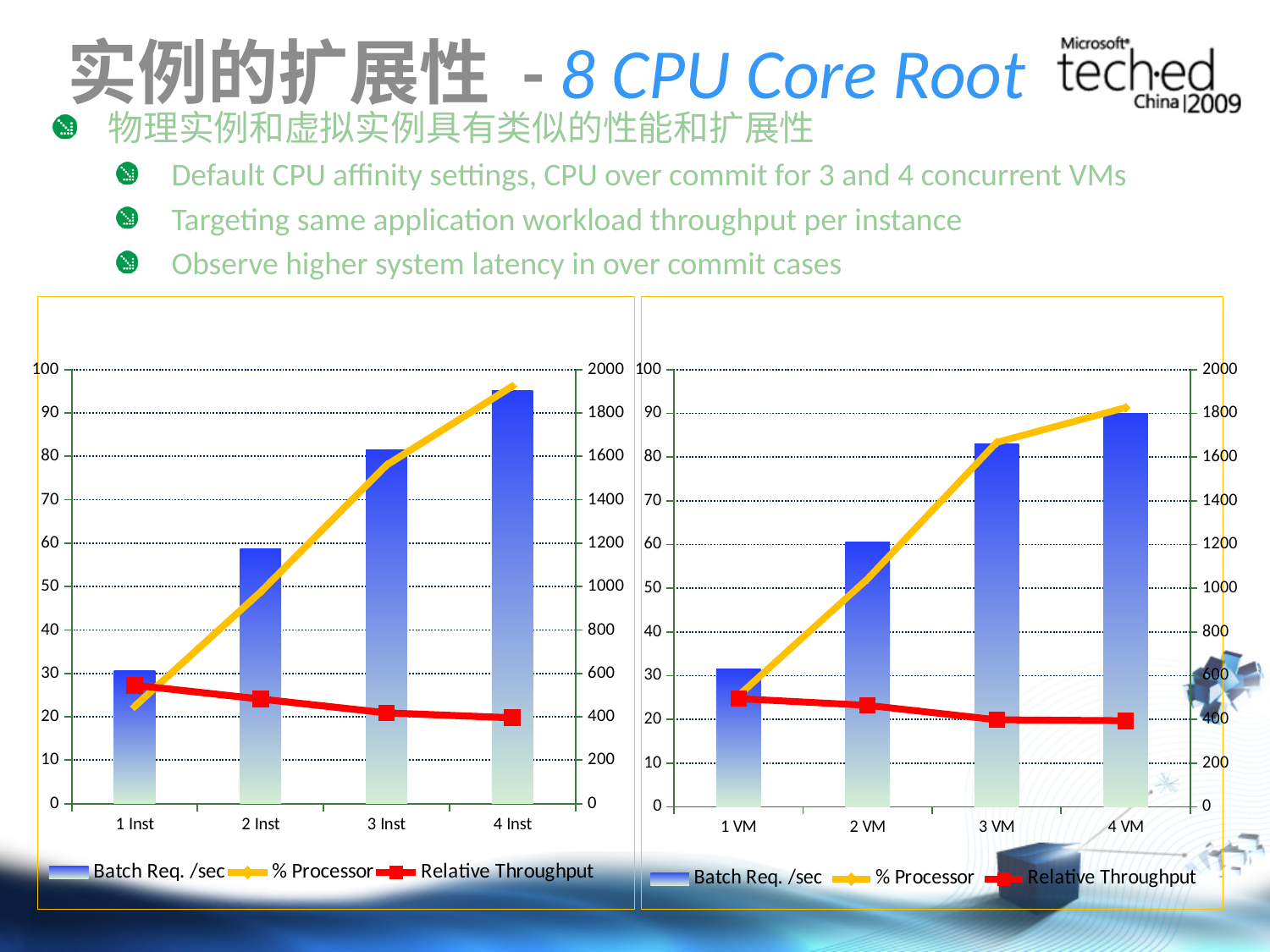
On the right chart, which category has the shortest Batch Req. /sec bar? 1 VM On the right chart, how many series does the legend list? 3 On the left chart, does the Relative Throughput line rise or fall from 1 Inst to 4 Inst? fall On the right chart, is the Batch Req. /sec bar for 2 VM greater or less than 50? greater On the left chart, is the Batch Req. /sec bar for 4 Inst greater or less than 90? greater What kind of chart is the right chart? Combined bar and line chart On the left chart, how many categories are shown on the x axis? 4 On the right chart, is the Batch Req. /sec bar for 4 VM greater or less than 80? greater On the left chart, which is larger, the Batch Req. /sec bar for 2 Inst or for 3 Inst? 3 Inst On the right chart, does the % Processor line rise or fall from 1 VM to 4 VM? rise On the left chart, which category has the tallest Batch Req. /sec bar? 4 Inst